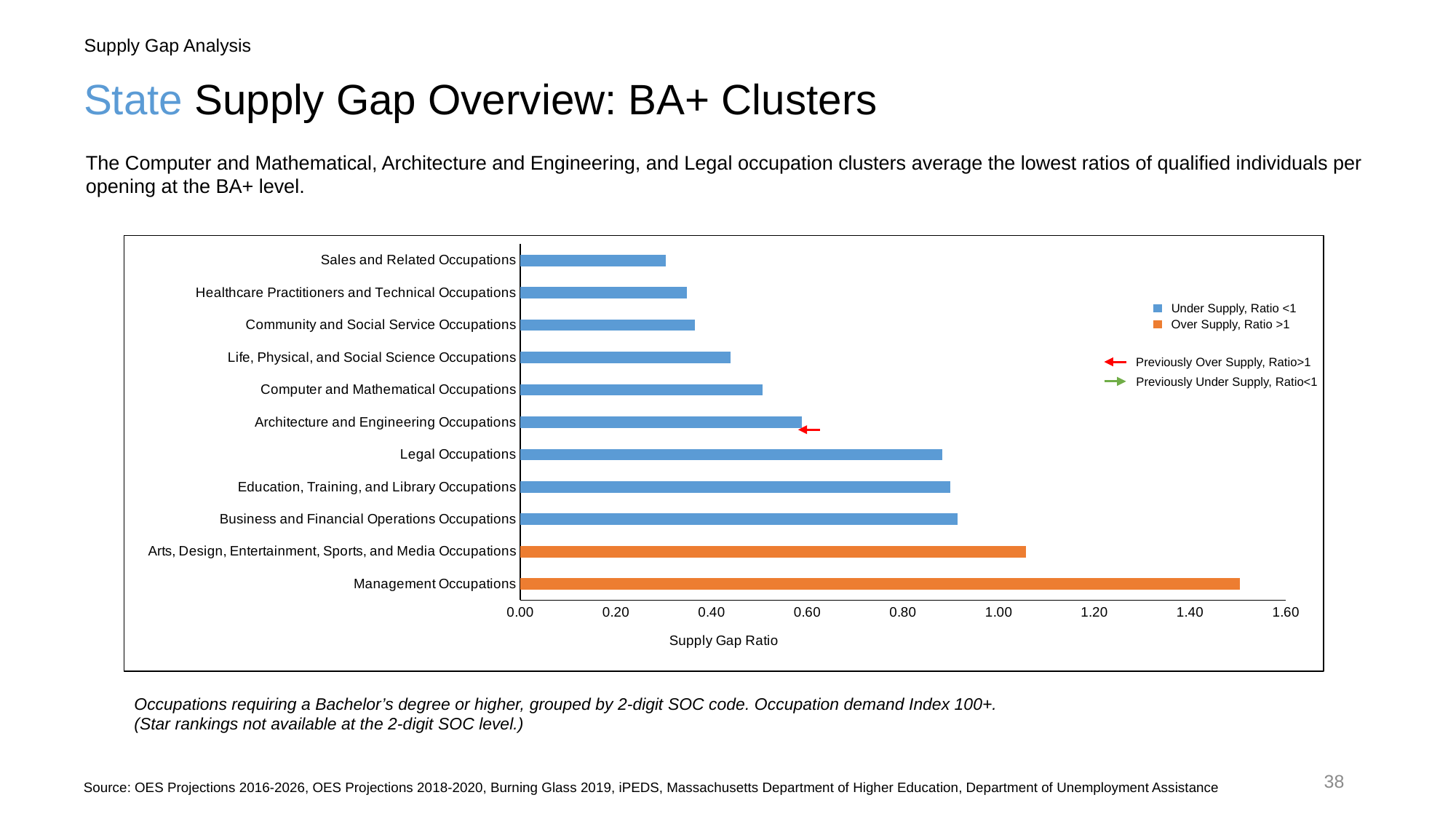
Which has a larger Supply Gap Ratio: Legal Occupations or Computer and Mathematical Occupations? Legal Occupations Is the Supply Gap Ratio for Arts, Design, Entertainment, Sports, and Media Occupations greater or less than 1.00? greater How many series does the chart legend list for the bars? 2 What colour are the bars for clusters labelled 'Over Supply, Ratio >1' in the legend? orange How many occupation clusters are plotted in the chart? 11 Which occupation cluster has the lowest Supply Gap Ratio? Sales and Related Occupations Is the Supply Gap Ratio for Sales and Related Occupations greater or less than 0.40? less Is the Supply Gap Ratio for Legal Occupations greater or less than 1.00? less What type of chart is shown on the slide? bar chart Which occupation cluster has the highest Supply Gap Ratio? Management Occupations Which has a larger Supply Gap Ratio: Management Occupations or Arts, Design, Entertainment, Sports, and Media Occupations? Management Occupations